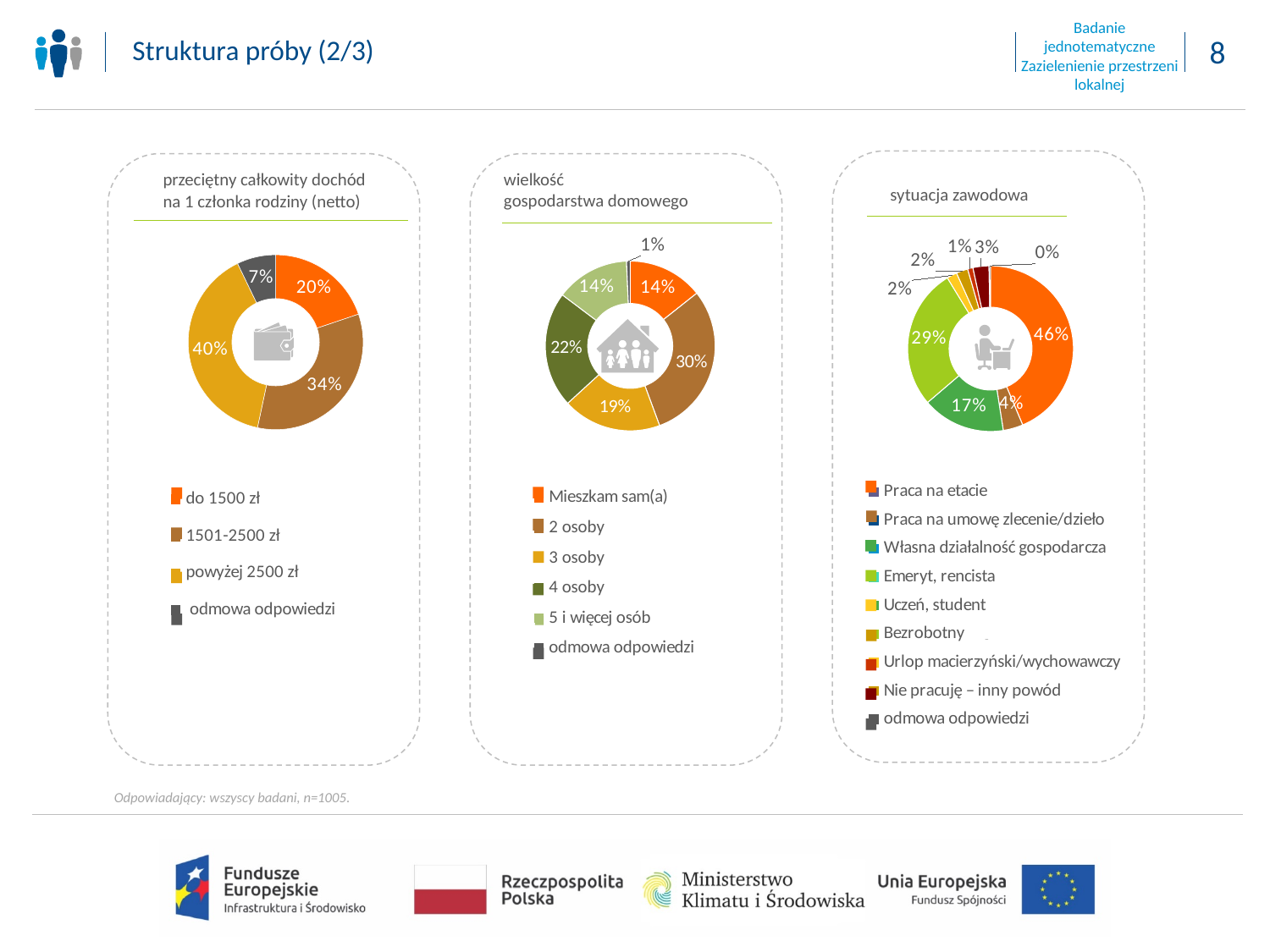
In the chart titled "wielkość gospodarstwa domowego", what share is shown for "2 osoby"? 30% In the chart titled "wielkość gospodarstwa domowego", which is larger: "3 osoby" or "4 osoby"? 4 osoby In the chart titled "sytuacja zawodowa", how many categories does the legend list? 9 In the chart titled "przeciętny całkowity dochód na 1 członka rodziny (netto)", what is the difference in percentage points between "1501-2500 zł" and "do 1500 zł"? 14 In the chart titled "sytuacja zawodowa", what share is shown for "Własna działalność gospodarcza"? 17% In the chart titled "przeciętny całkowity dochód na 1 członka rodziny (netto)", what share is shown for "powyżej 2500 zł"? 40% In the chart titled "przeciętny całkowity dochód na 1 członka rodziny (netto)", which category has the smallest share? odmowa odpowiedzi What type of chart is used for "przeciętny całkowity dochód na 1 członka rodziny (netto)"? Donut (pie) chart In the chart titled "sytuacja zawodowa", what share is shown for "Emeryt, rencista"? 29% In the chart titled "wielkość gospodarstwa domowego", how many categories does the legend list? 6 In the chart titled "sytuacja zawodowa", which category has the largest share? Praca na etacie In the chart titled "wielkość gospodarstwa domowego", which category has the largest share? 2 osoby